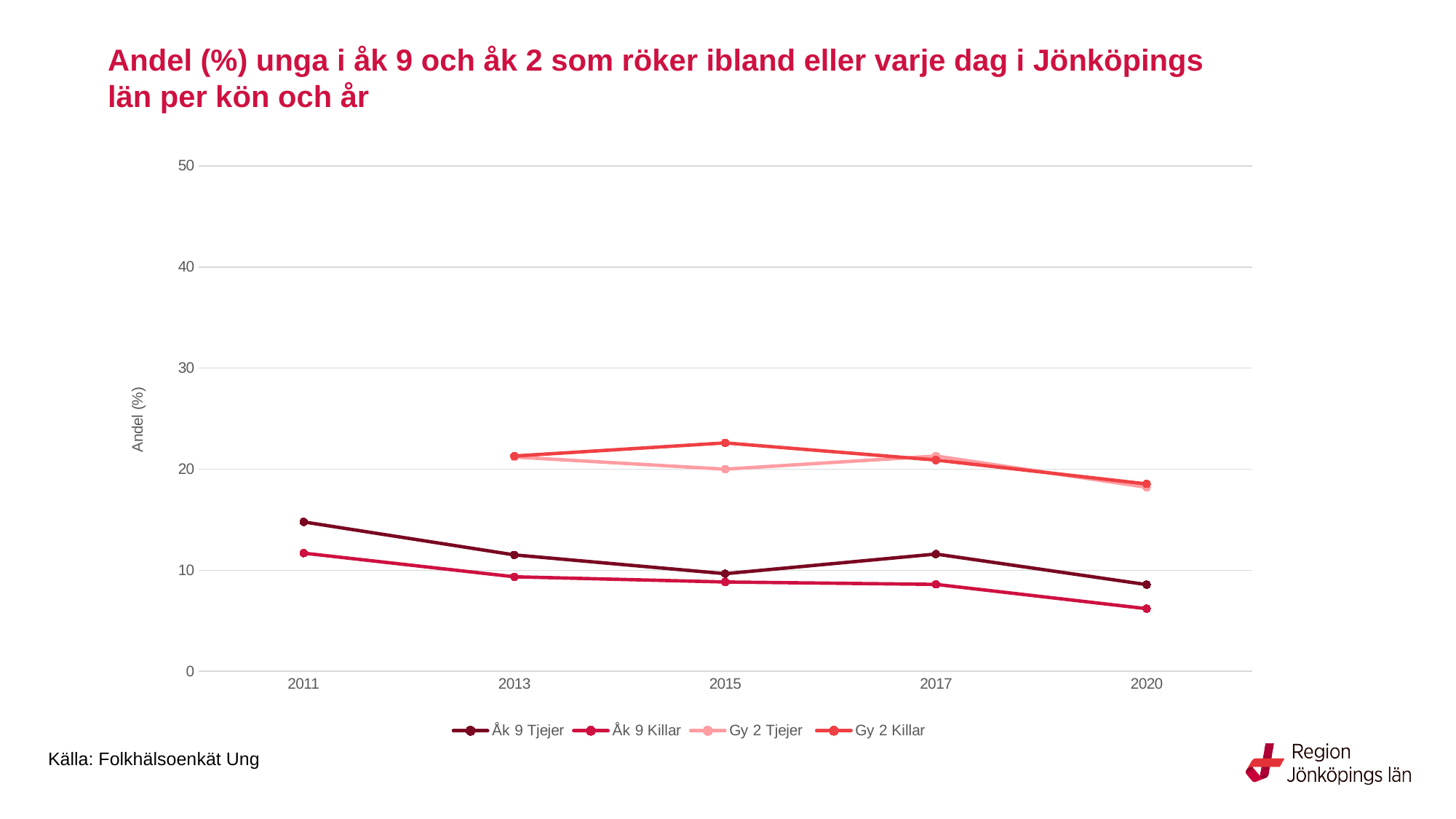
Does the Åk 9 Killar line rise or fall from 2011 to 2020? fall How many series does the legend list? 4 In 2011, which is larger: Åk 9 Tjejer or Åk 9 Killar? Åk 9 Tjejer How many years are shown on the x axis? 5 In 2015, which is larger: Gy 2 Killar or Gy 2 Tjejer? Gy 2 Killar Is the value for Åk 9 Tjejer in 2011 greater or less than 10? greater Is the value for Gy 2 Killar in 2015 greater or less than 20? greater Which series has the lowest value in 2020? Åk 9 Killar Is the value for Gy 2 Tjejer in 2020 greater or less than 20? less What is the label on the y axis? Andel (%) What kind of chart is shown on the slide? line chart